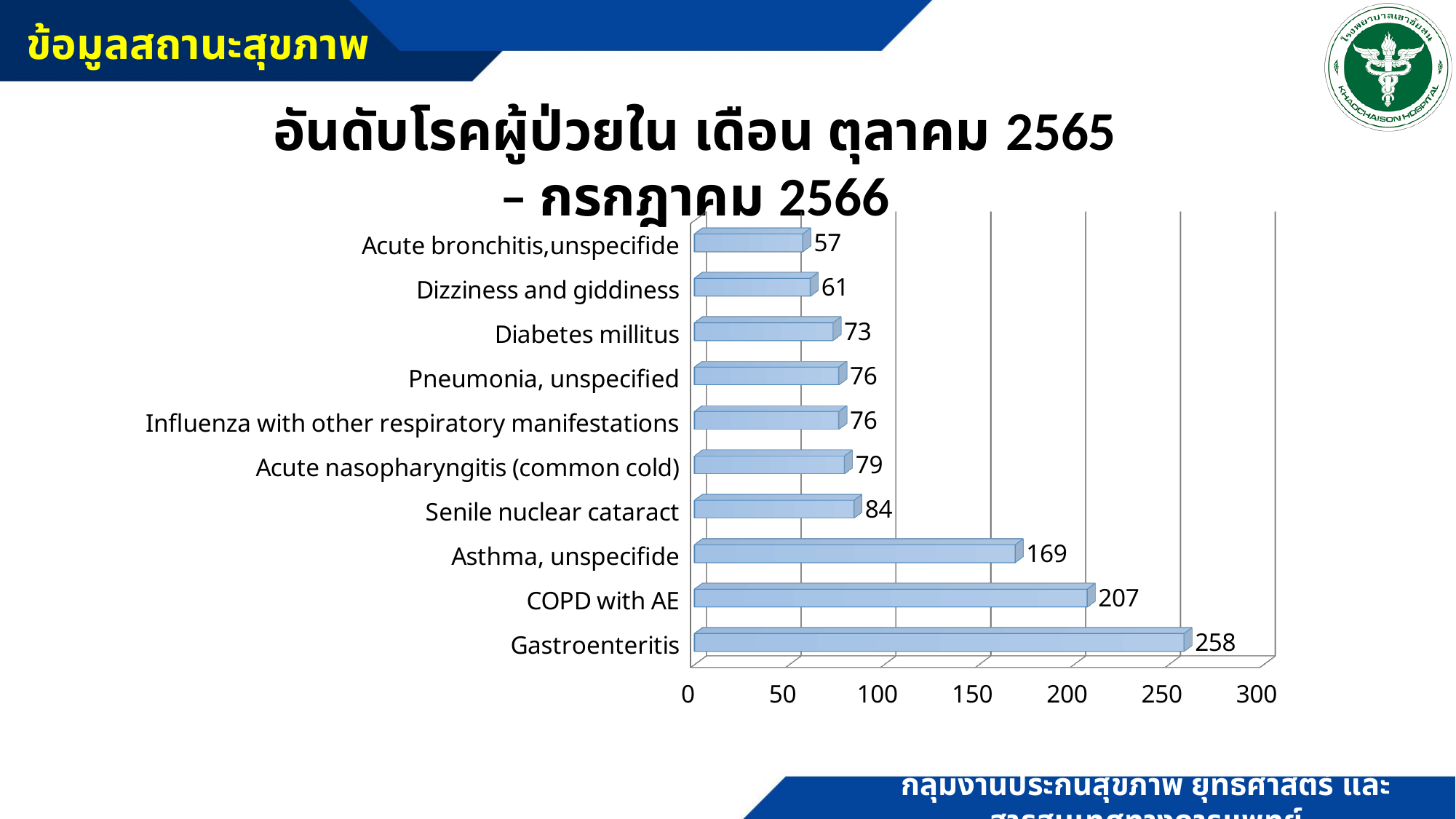
What is the value for Gastroenteritis? 258 What is the difference between the values for Gastroenteritis and COPD with AE? 51 Which category has the highest value? Gastroenteritis What is the value for Dizziness and giddiness? 61 What is the value for COPD with AE? 207 What is the value for Senile nuclear cataract? 84 Which category has the lowest value? Acute bronchitis,unspecifide What kind of chart is shown on the slide? Bar chart How many categories are shown in the chart? 10 Which is larger, the value for Diabetes millitus or the value for Acute nasopharyngitis (common cold)? Acute nasopharyngitis (common cold) What is the difference between the values for Asthma, unspecifide and Senile nuclear cataract? 85 What is the highest value shown on the horizontal axis? 300